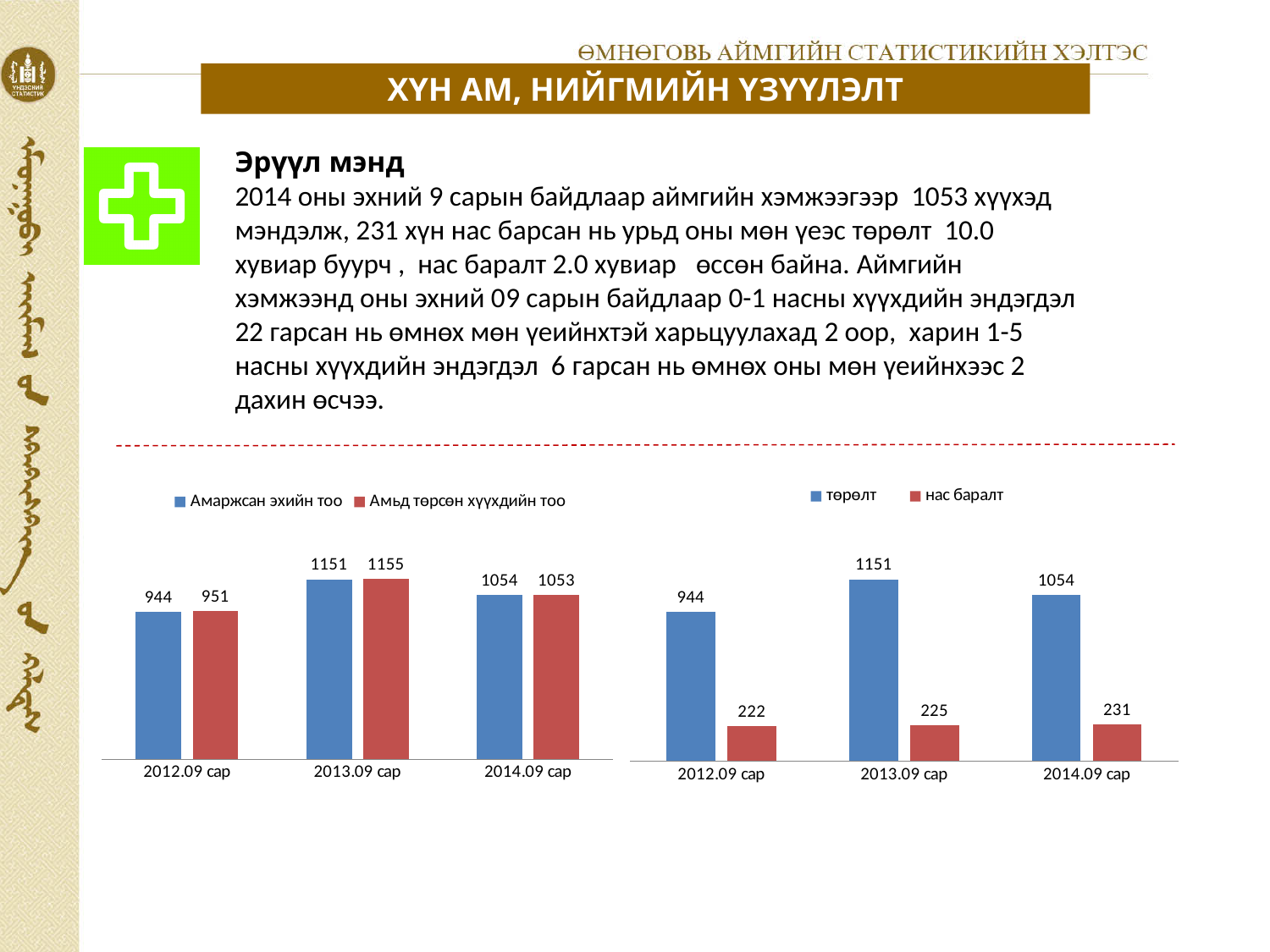
What kind of chart is the left chart? bar chart In the right chart, which is larger: нас баралт for 2013.09 сар or нас баралт for 2014.09 сар? 2014.09 сар In the left chart, what is the value of Амаржсан эхийн тоо for 2013.09 сар? 1151 In the right chart, which category has the lowest value for нас баралт? 2012.09 сар How many series does the legend of the right chart list? 2 How many categories are shown on the x axis of the left chart? 3 In the left chart, what is the value of Амьд төрсөн хүүхдийн тоо for 2012.09 сар? 951 In the right chart, what is the difference between төрөлт and нас баралт for 2014.09 сар? 823 In the left chart, what is the difference between Амьд төрсөн хүүхдийн тоо and Амаржсан эхийн тоо for 2013.09 сар? 4 In the right chart, what is the value of нас баралт for 2014.09 сар? 231 In the right chart, do the values for нас баралт rise or fall from 2012.09 сар to 2014.09 сар? rise In the right chart, which category has the highest value for төрөлт? 2013.09 сар